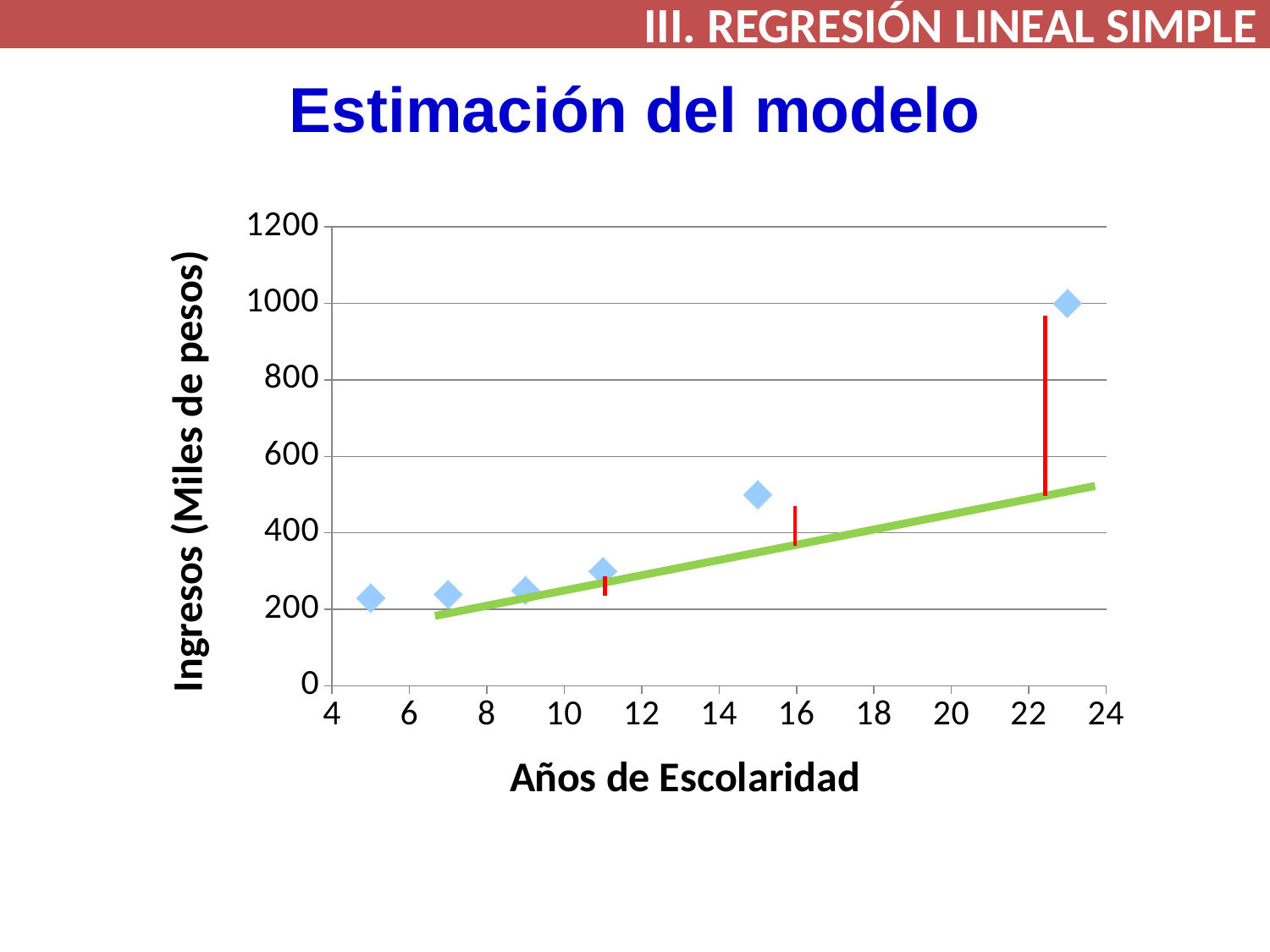
What is the title of the x axis? Años de Escolaridad How many data points (diamond markers) are plotted on the chart? 6 Is the income value for the point at 11 years of schooling greater or less than 400? less Do the plotted income values rise or fall as years of schooling increase? Rise At which number of years of schooling is the plotted income highest? 23 What is the title of the y axis? Ingresos (Miles de pesos) Which point has the highest income value: the one at 23 years of schooling or the one at 15 years? 23 years What kind of chart is shown on the slide? Scatter plot Is the income value for the point at 15 years of schooling greater or less than 400? greater Is the income value for the point at 23 years of schooling greater or less than 800? greater At which number of years of schooling is the plotted income lowest? 5